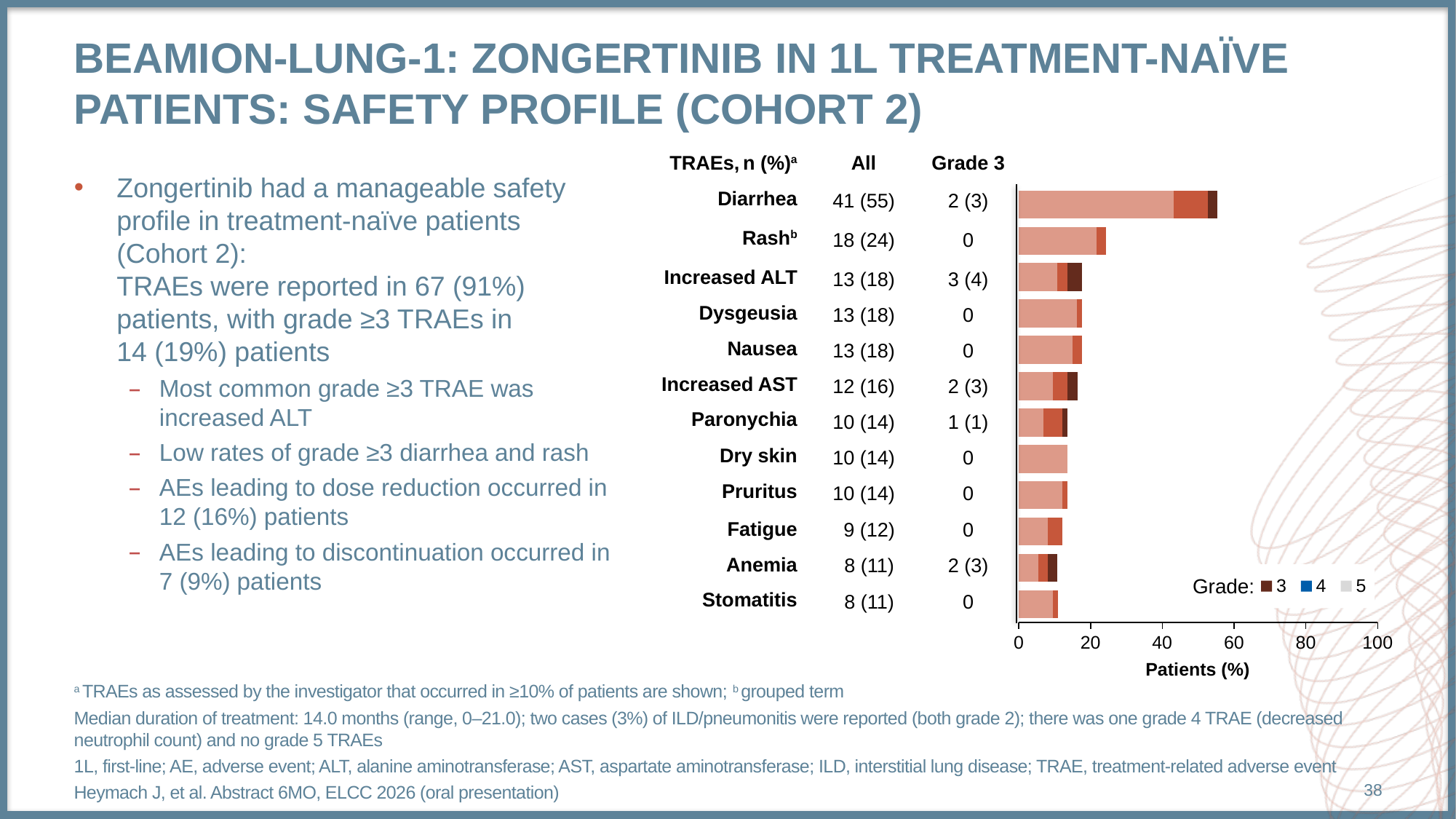
What is the label on the x axis of the chart? Patients (%) How many TRAE categories are plotted in the chart? 12 What is the 'All' value shown for Diarrhea? 41 (55) Which has a higher overall percentage of patients, Diarrhea or Rash? Diarrhea What kind of chart is shown on the slide? bar chart Which TRAE has the highest overall percentage of patients? Diarrhea What is the 'All' value shown for Rash? 18 (24) What is the difference in percentage points between the overall rate for Diarrhea (55%) and Rash (24%)? 31 Is the overall value for Diarrhea greater or less than 40? greater Is the overall value for Stomatitis greater or less than 20? less What is the Grade 3 value shown for Increased ALT? 3 (4) How many grade entries does the chart legend list? 3